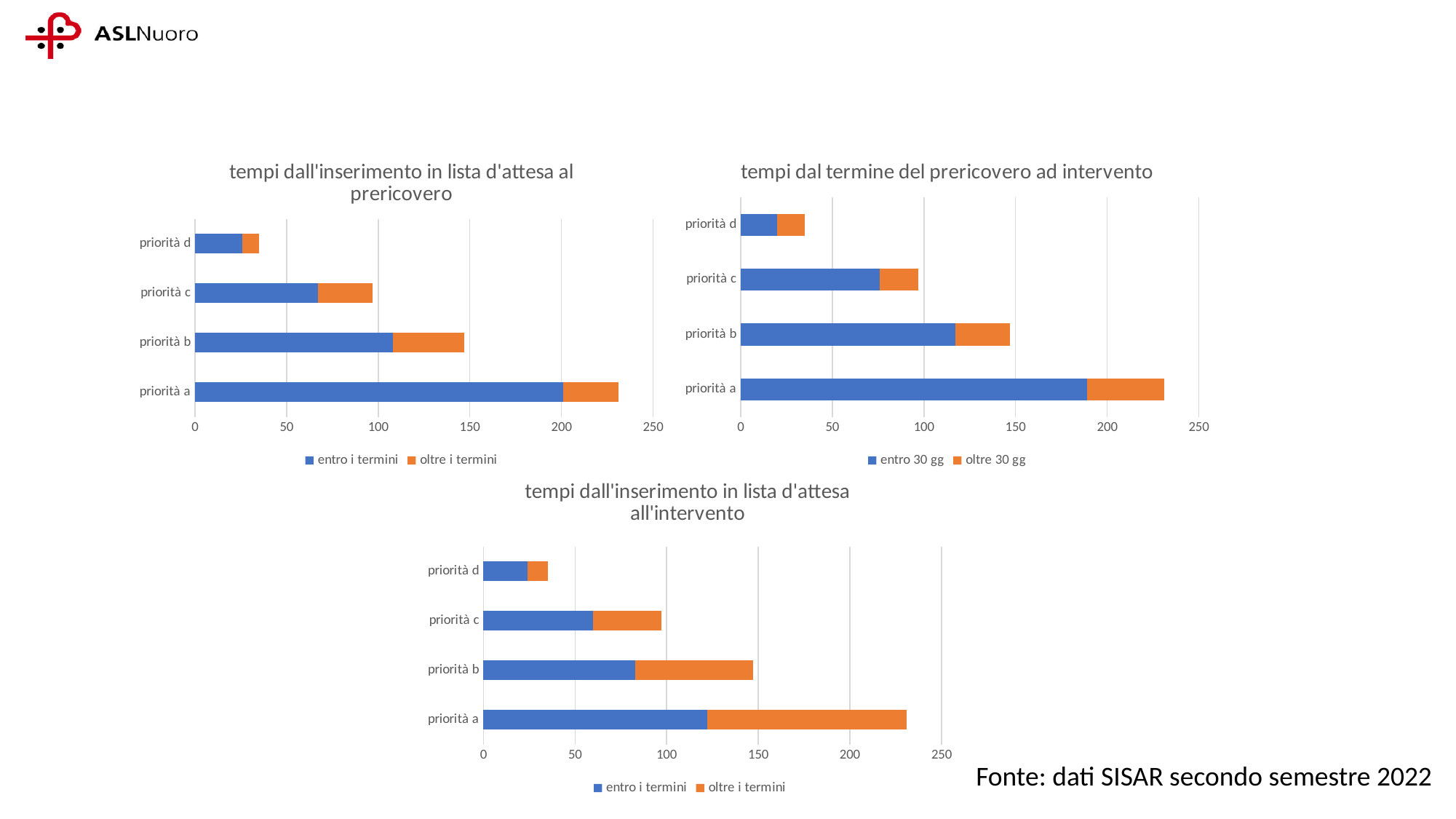
In the chart titled "tempi dal termine del prericovero ad intervento", is the "entro 30 gg" value for priorità a greater or less than 150? greater In the chart titled "tempi dall'inserimento in lista d'attesa al prericovero", which priority has the longest total bar? priorità a In the chart titled "tempi dall'inserimento in lista d'attesa al prericovero", which priority has the shortest total bar? priorità d In the chart titled "tempi dall'inserimento in lista d'attesa al prericovero", is the total value for priorità d greater or less than 50? less In the chart titled "tempi dal termine del prericovero ad intervento", which is larger, the total bar for priorità b or for priorità c? priorità b In the chart titled "tempi dal termine del prericovero ad intervento", what are the two legend entries? entro 30 gg, oltre 30 gg In the chart titled "tempi dall'inserimento in lista d'attesa all'intervento", is the "entro i termini" value for priorità a greater or less than 100? greater In the chart titled "tempi dall'inserimento in lista d'attesa all'intervento", how many priority categories are shown? 4 In the chart titled "tempi dal termine del prericovero ad intervento", how many series does the legend list? 2 What type of chart is the one titled "tempi dall'inserimento in lista d'attesa all'intervento"? stacked bar chart In the chart titled "tempi dall'inserimento in lista d'attesa all'intervento", which is larger for priorità b, the "entro i termini" segment or the "oltre i termini" segment? entro i termini